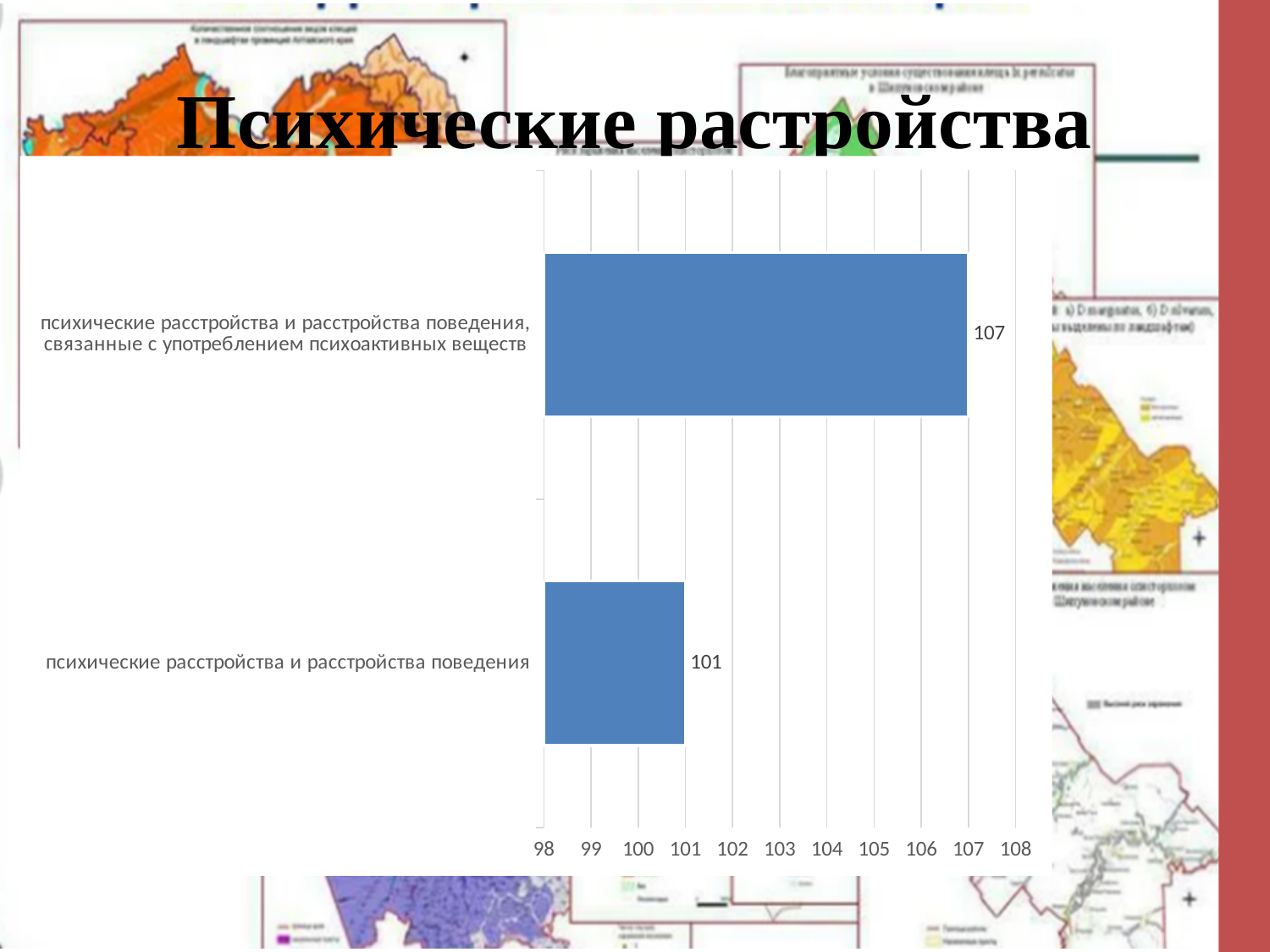
Which is larger: the value for "психические расстройства и расстройства поведения" or the value for "психические расстройства и расстройства поведения, связанные с употреблением психоактивных веществ"? психические расстройства и расстройства поведения, связанные с употреблением психоактивных веществ Is the value for "психические расстройства и расстройства поведения, связанные с употреблением психоактивных веществ" greater or less than 105? greater What is the value for "психические расстройства и расстройства поведения, связанные с употреблением психоактивных веществ"? 107 Which category has the highest value? психические расстройства и расстройства поведения, связанные с употреблением психоактивных веществ Is the value for "психические расстройства и расстройства поведения" greater or less than 104? less Which category has the lowest value? психические расстройства и расстройства поведения What kind of chart is shown on the slide? bar chart What is the difference between the values for the two categories? 6 What is the value for "психические расстройства и расстройства поведения"? 101 How many categories are shown in the chart? 2 What is the minimum value shown on the horizontal axis? 98 What is the title of the slide? Психические растройства